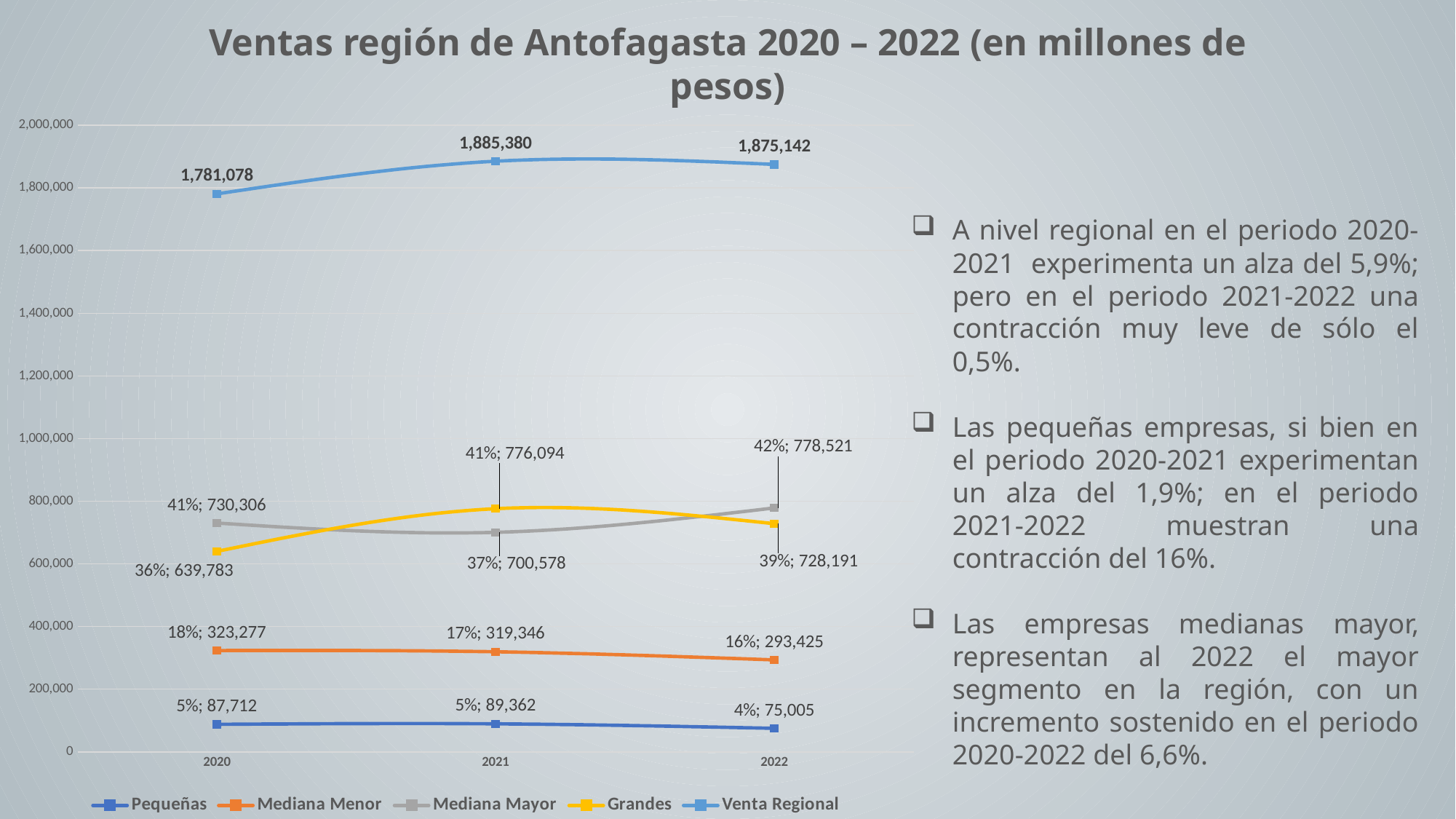
How many years are plotted along the x axis? 3 What kind of chart is shown on the slide? line chart How many series does the legend list? 5 What is the value for Grandes in 2021? 776,094 In which year is the value for Pequeñas lowest? 2022 What is the title of the chart? Ventas región de Antofagasta 2020 – 2022 (en millones de pesos) What is the difference between Venta Regional in 2021 and in 2022? 10,238 In 2022, which is larger: Mediana Mayor or Grandes? Mediana Mayor In which year is Venta Regional highest? 2021 What is the value for Pequeñas in 2022? 75,005 Does the Mediana Menor series rise or fall from 2020 to 2022? fall What is the value of Venta Regional in 2021? 1,885,380